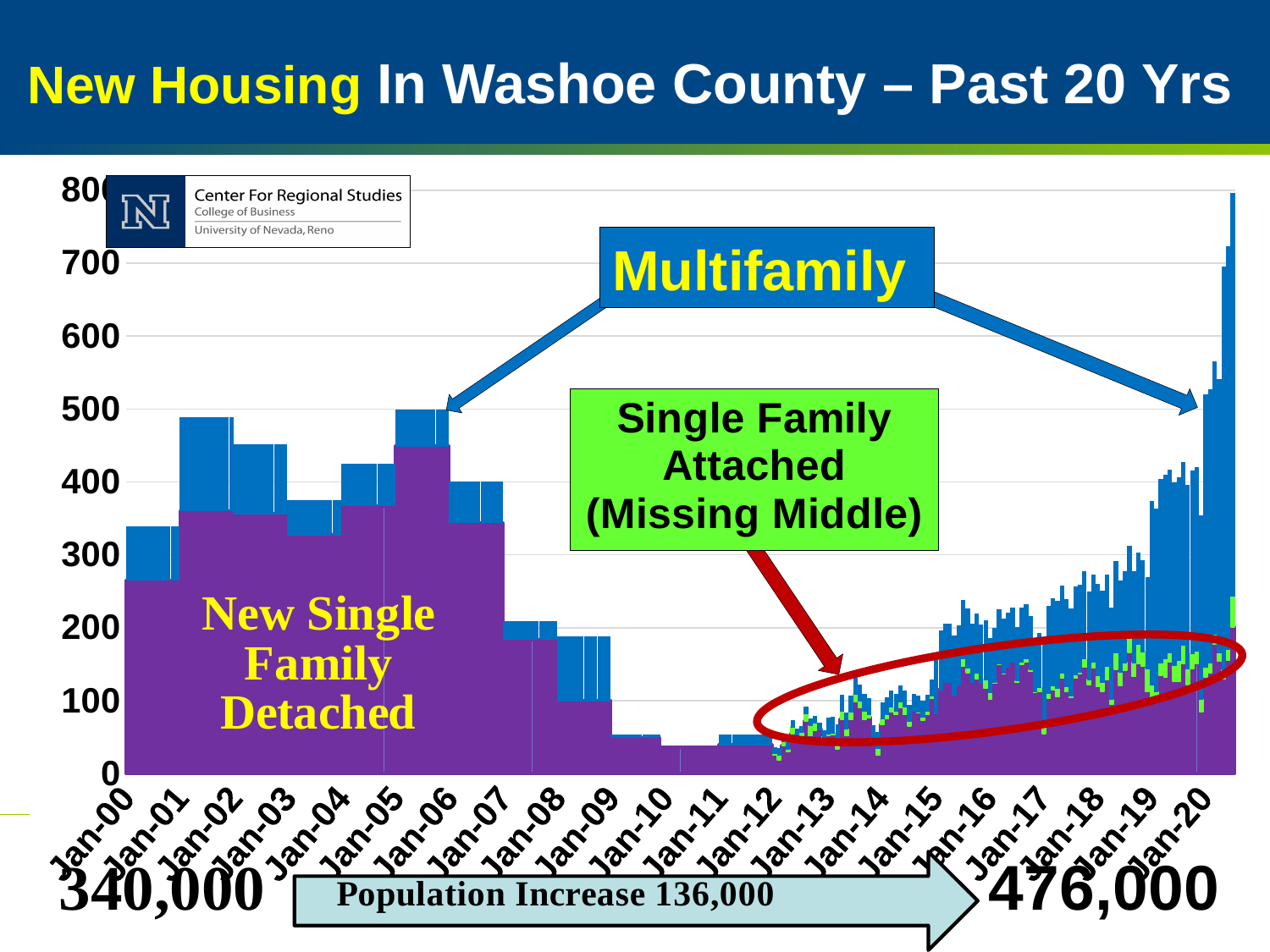
How many housing types are labelled on the chart? 3 Is the total value of the bar at Jan-11 greater or less than 100? less How many year labels (Jan-00 through Jan-20) appear on the x axis? 21 What population increase is stated below the chart? 136,000 Is the total value of the bar at Jan-00 greater or less than 300? greater Which bar is taller, the one at Jan-05 or the one at Jan-15? Jan-05 Do the bar totals rise or fall between Jan-11 and Jan-20? rise Is the total value of the bar at Jan-02 greater or less than 400? greater What kind of chart is shown on the slide? bar chart Do the bar totals rise or fall between Jan-05 and Jan-10? fall Near which x-axis label is the tallest bar on the chart? Jan-20